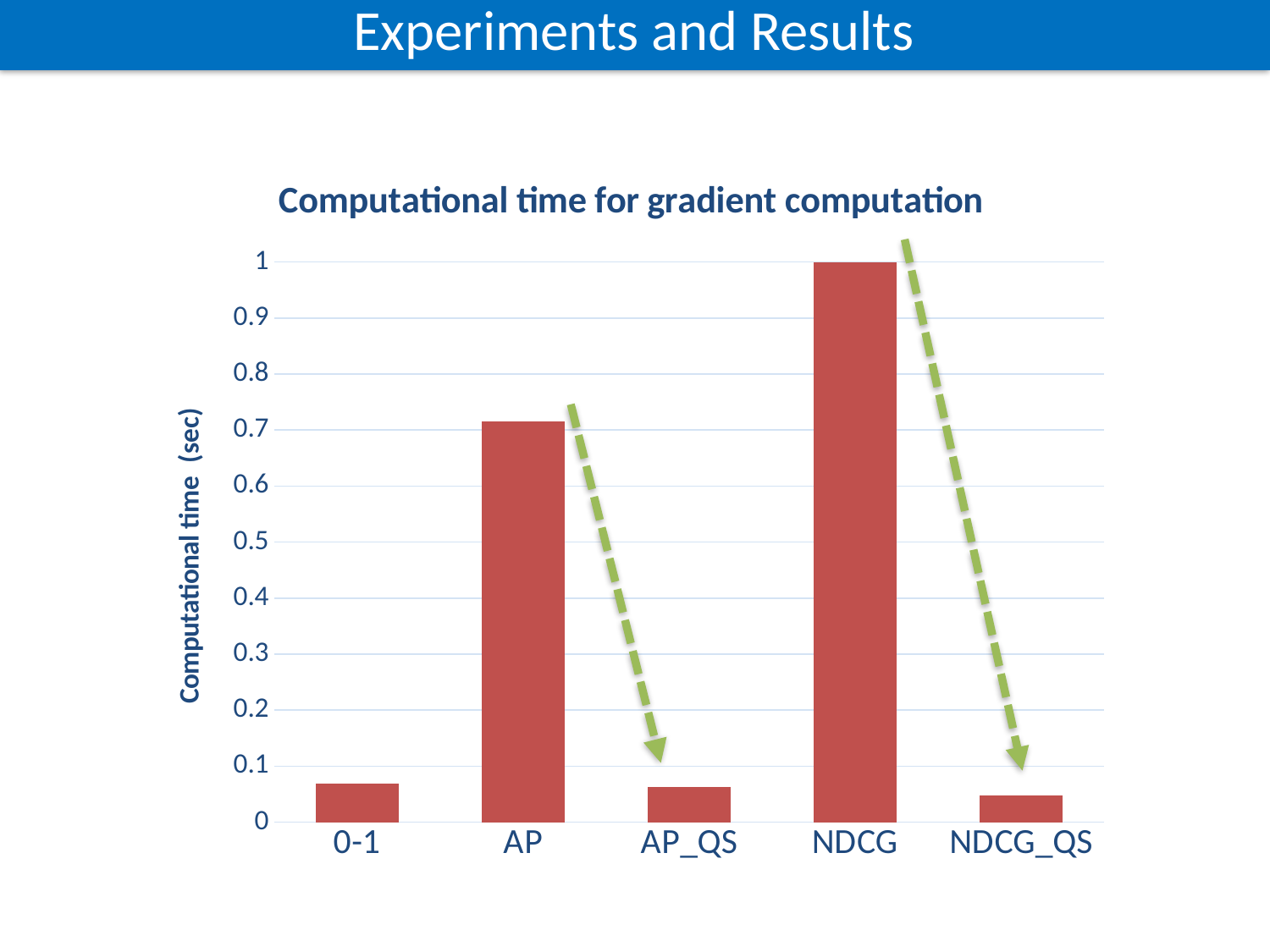
Is the value for AP_QS greater or less than 0.1? less Which category has the highest computational time? NDCG Which is larger, the value for AP or the value for AP_QS? AP Is the value for AP greater or less than 0.6? greater Is the value for 0-1 greater or less than 0.2? less What is the label of the vertical axis? Computational time (sec) What is the title of the chart? Computational time for gradient computation Which is larger, the value for NDCG or the value for NDCG_QS? NDCG How many categories are shown on the x axis? 5 What kind of chart is shown on the slide? bar chart